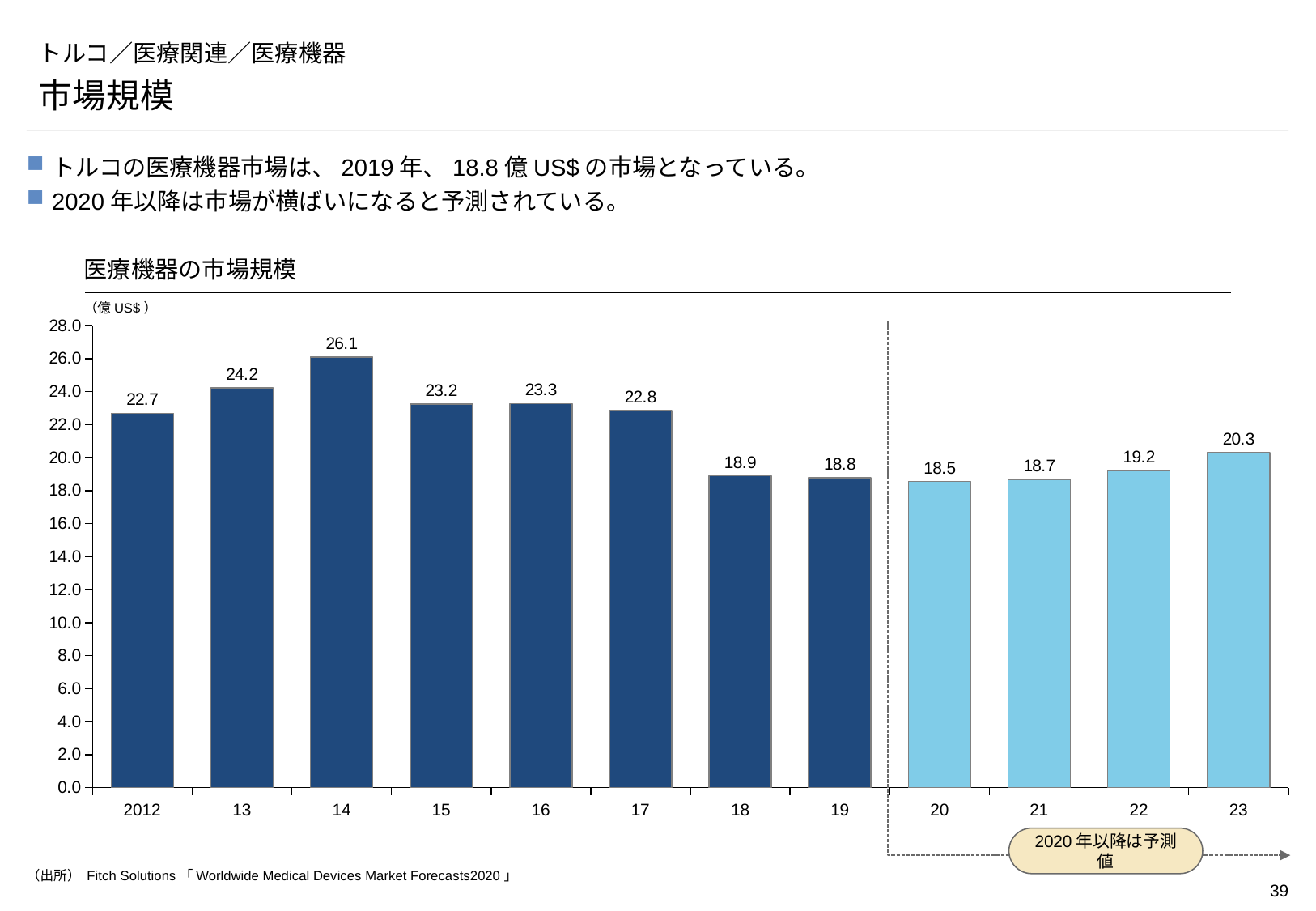
Which year has the lowest value in the chart? 20 Do the values rise or fall from 2020 to 2023? rise What is the value for 2023 in the chart? 20.3 Which year has the highest value in the chart? 14 How many years are shown on the x axis of the chart? 12 What is the unit shown above the y axis of the chart? 億US$ What is the value for 2019 in the chart? 18.8 Is the value for 2018 greater or less than 20.0? less Which is larger, the value for 2013 or the value for 2017? 2013 What is the difference between the values for 2014 and 2019? 7.3 What kind of chart is shown on the slide? bar chart What is the value for 2014 in the 医療機器の市場規模 chart? 26.1